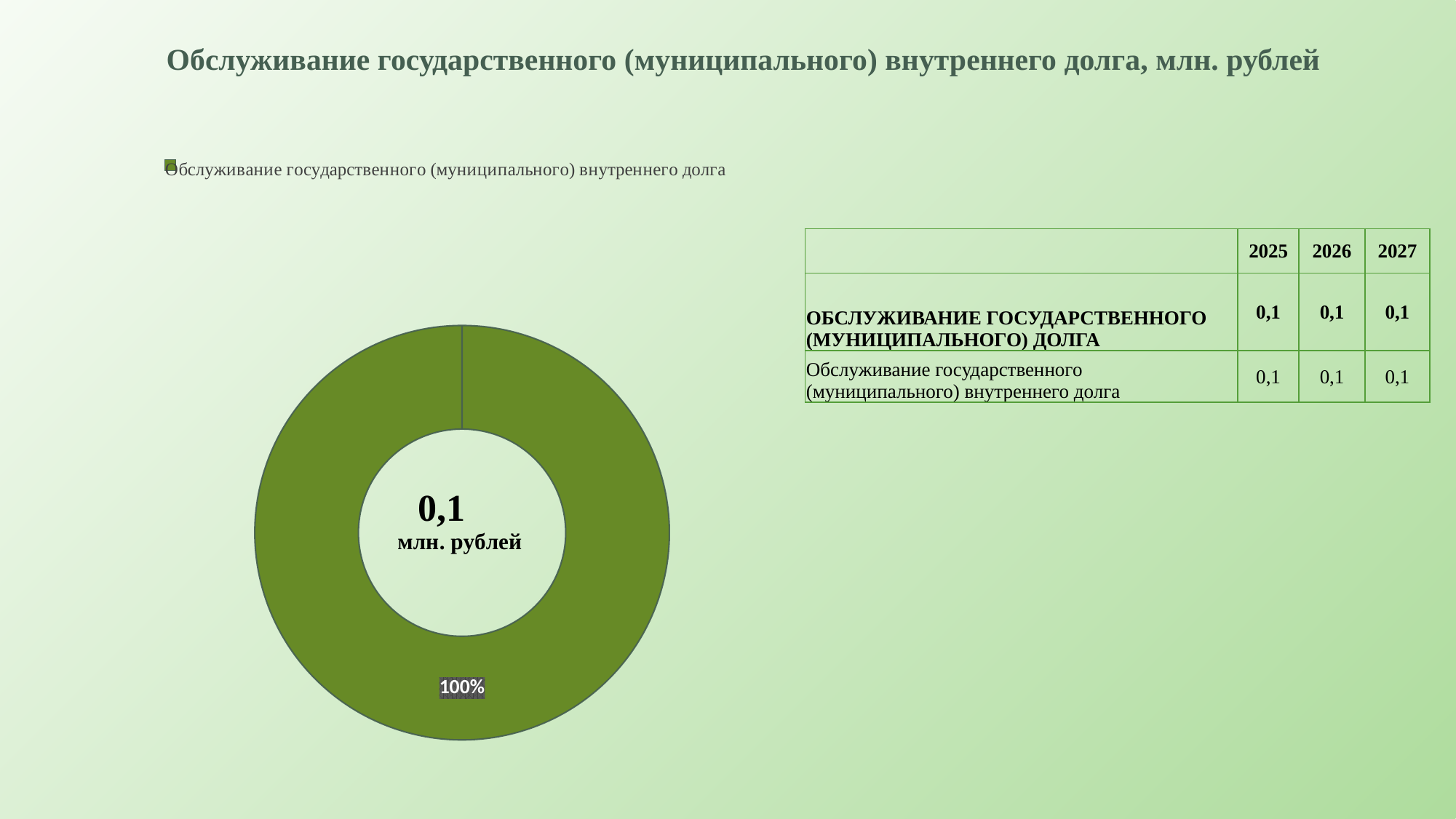
What colour is the single slice of the doughnut chart? Green What value is printed in the centre of the doughnut chart? 0,1 млн. рублей What is the title of the chart on the slide? Обслуживание государственного (муниципального) внутреннего долга, млн. рублей How many series does the chart legend list? 1 What is the value for 'Обслуживание государственного (муниципального) внутреннего долга' shown in the chart? 0,1 What kind of chart is shown on the slide? Doughnut (pie) chart How many slices does the doughnut chart have? 1 What share of the doughnut chart does the slice 'Обслуживание государственного (муниципального) внутреннего долга' take? 100%